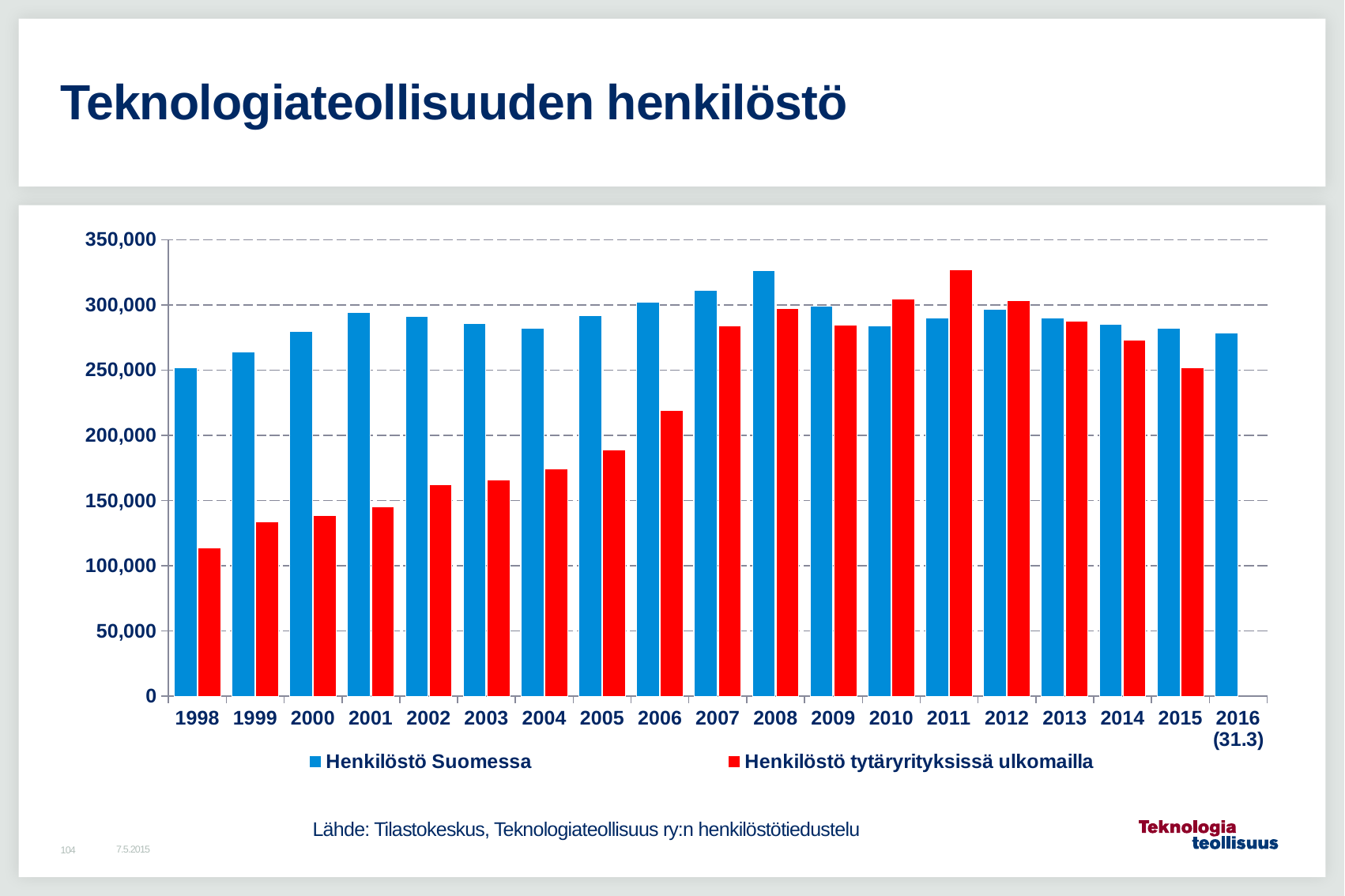
Is the value for Henkilöstö tytäryrityksissä ulkomailla in 2005 greater or less than 200,000? less Is the value for Henkilöstö Suomessa in 2008 greater or less than 300,000? greater How many years (categories) are shown on the x axis? 19 In which year is the value for Henkilöstö tytäryrityksissä ulkomailla highest? 2011 How many series does the legend list? 2 In which year is the value for Henkilöstö tytäryrityksissä ulkomailla lowest? 1998 In which year is the value for Henkilöstö Suomessa highest? 2008 In 2011, which series has the larger value, Henkilöstö Suomessa or Henkilöstö tytäryrityksissä ulkomailla? Henkilöstö tytäryrityksissä ulkomailla What kind of chart is shown on the slide? bar chart In which year is the value for Henkilöstö Suomessa lowest? 1998 Does the value for Henkilöstö tytäryrityksissä ulkomailla rise or fall from 1998 to 2011? rise Which colour represents Henkilöstö Suomessa in the chart? blue